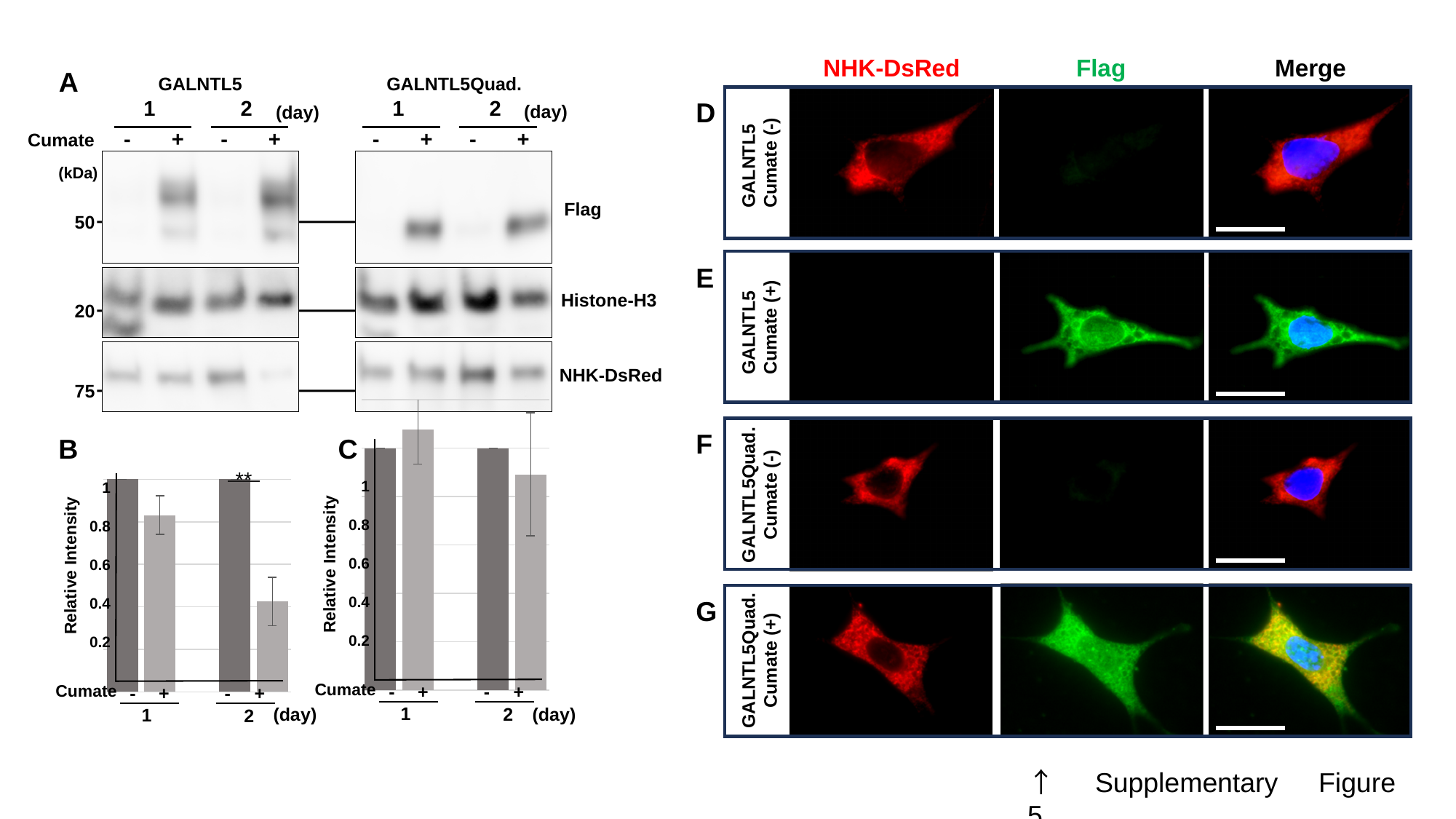
In chart B, which bar has the lowest relative intensity? Cumate + at day 2 What is the y-axis label of chart B? Relative Intensity How many bars are plotted in chart C? 4 In chart B, is the value for Cumate + at day 1 greater or less than 0.6? greater How many bars are plotted in chart B? 4 What kind of chart is chart C? bar chart In chart B, which day group is marked with the significance symbol "**"? day 2 What kind of chart is chart B? bar chart In chart C, is the value for Cumate + at day 2 greater or less than 0.6? greater In chart B, which is larger: the Cumate + bar at day 1 or the Cumate + bar at day 2? Cumate + at day 1 In chart B, is the value for Cumate + at day 1 greater or less than 1? less